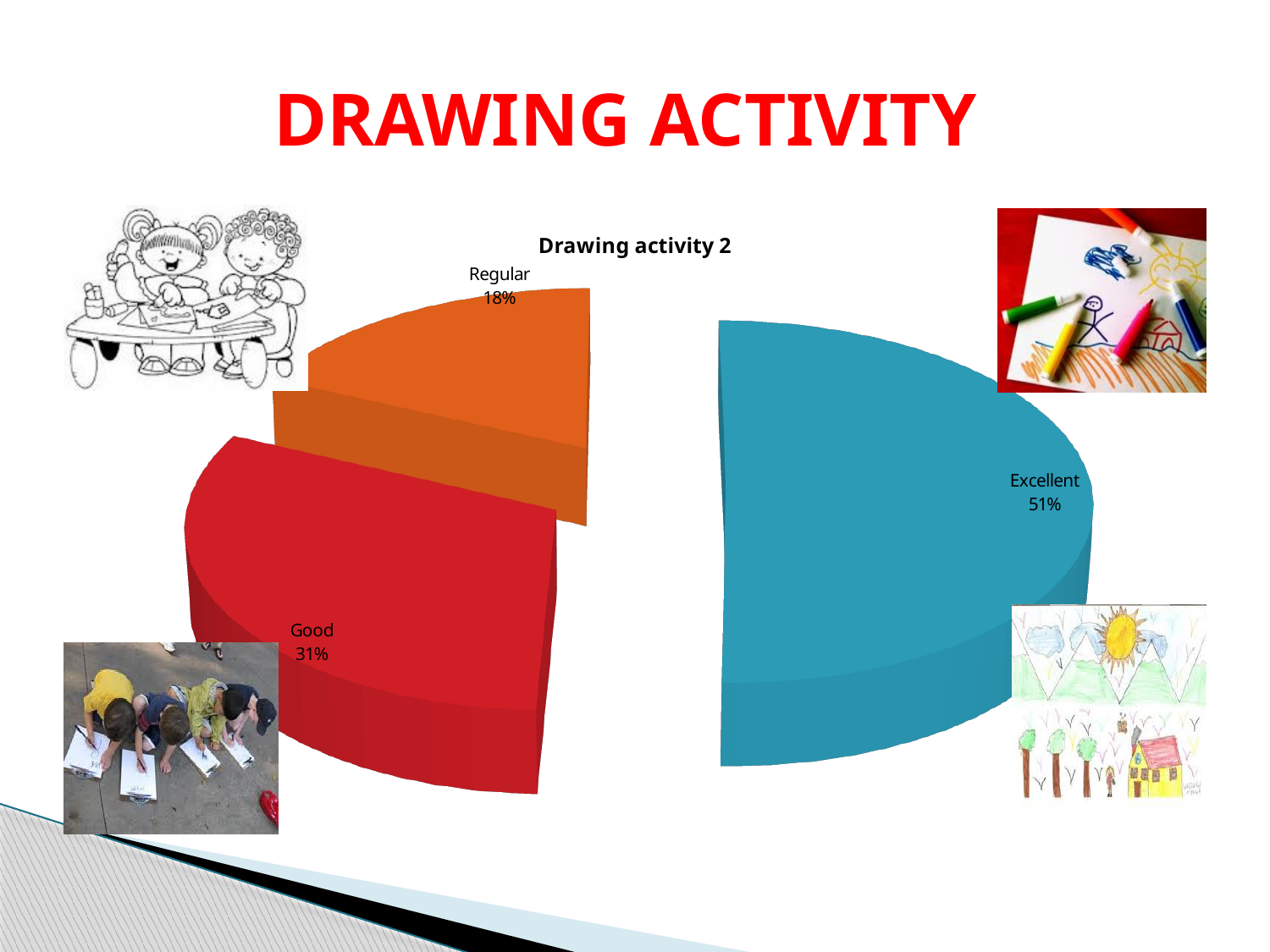
What colour is the Excellent slice of the pie chart? Blue Which category has the largest share of the pie chart? Excellent How many slices does the pie chart have? 3 What percentage of the pie chart is labelled Excellent? 51% What is the difference in percentage points between the Excellent and Good slices? 20 What is the title of the chart? Drawing activity 2 Which slice is larger, Good or Regular? Good Which category has the smallest share of the pie chart? Regular What percentage of the pie chart is labelled Good? 31% What kind of chart is shown on the slide? Pie chart What is the difference in percentage points between the Good and Regular slices? 13 What percentage of the pie chart is labelled Regular? 18%